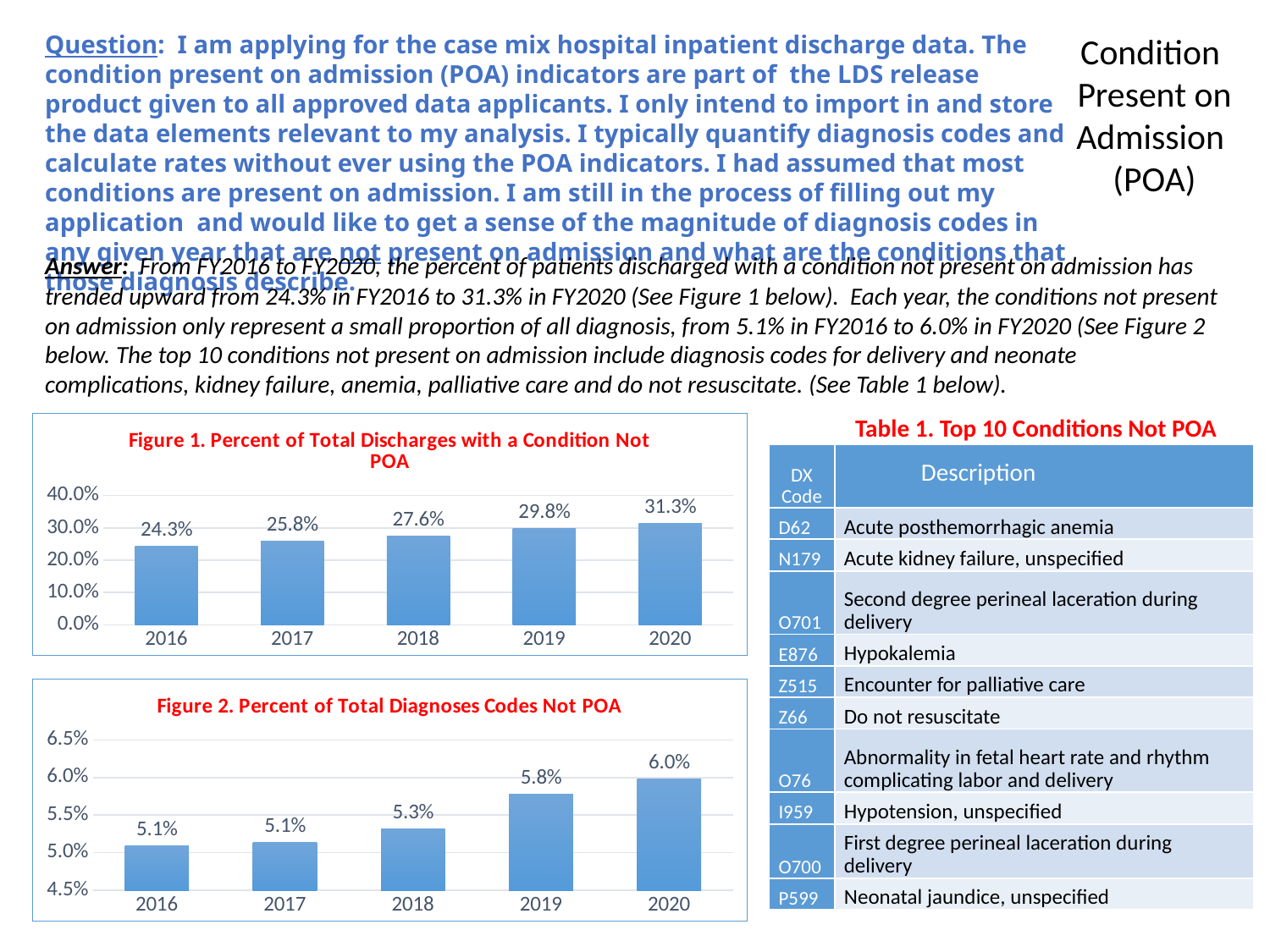
In Figure 1 (Percent of Total Discharges with a Condition Not POA), what is the value for 2018? 27.6% In Figure 2 (Percent of Total Diagnoses Codes Not POA), is the value for 2019 larger or smaller than the value for 2018? larger In Figure 1 (Percent of Total Discharges with a Condition Not POA), which year has the highest value? 2020 In Figure 2 (Percent of Total Diagnoses Codes Not POA), what is the value for 2017? 5.1% In Figure 2 (Percent of Total Diagnoses Codes Not POA), what is the value for 2019? 5.8% In Figure 1 (Percent of Total Discharges with a Condition Not POA), what is the difference between the 2020 and 2016 values? 7.0% In Figure 2 (Percent of Total Diagnoses Codes Not POA), what is the difference between the 2020 and 2018 values? 0.7% What type of chart is Figure 2 (Percent of Total Diagnoses Codes Not POA)? bar chart In Figure 2 (Percent of Total Diagnoses Codes Not POA), which year has the highest value? 2020 In Figure 1 (Percent of Total Discharges with a Condition Not POA), which year has the lowest value? 2016 In Figure 1 (Percent of Total Discharges with a Condition Not POA), how many years are plotted? 5 In Figure 1 (Percent of Total Discharges with a Condition Not POA), do the values rise or fall from 2016 to 2020? rise